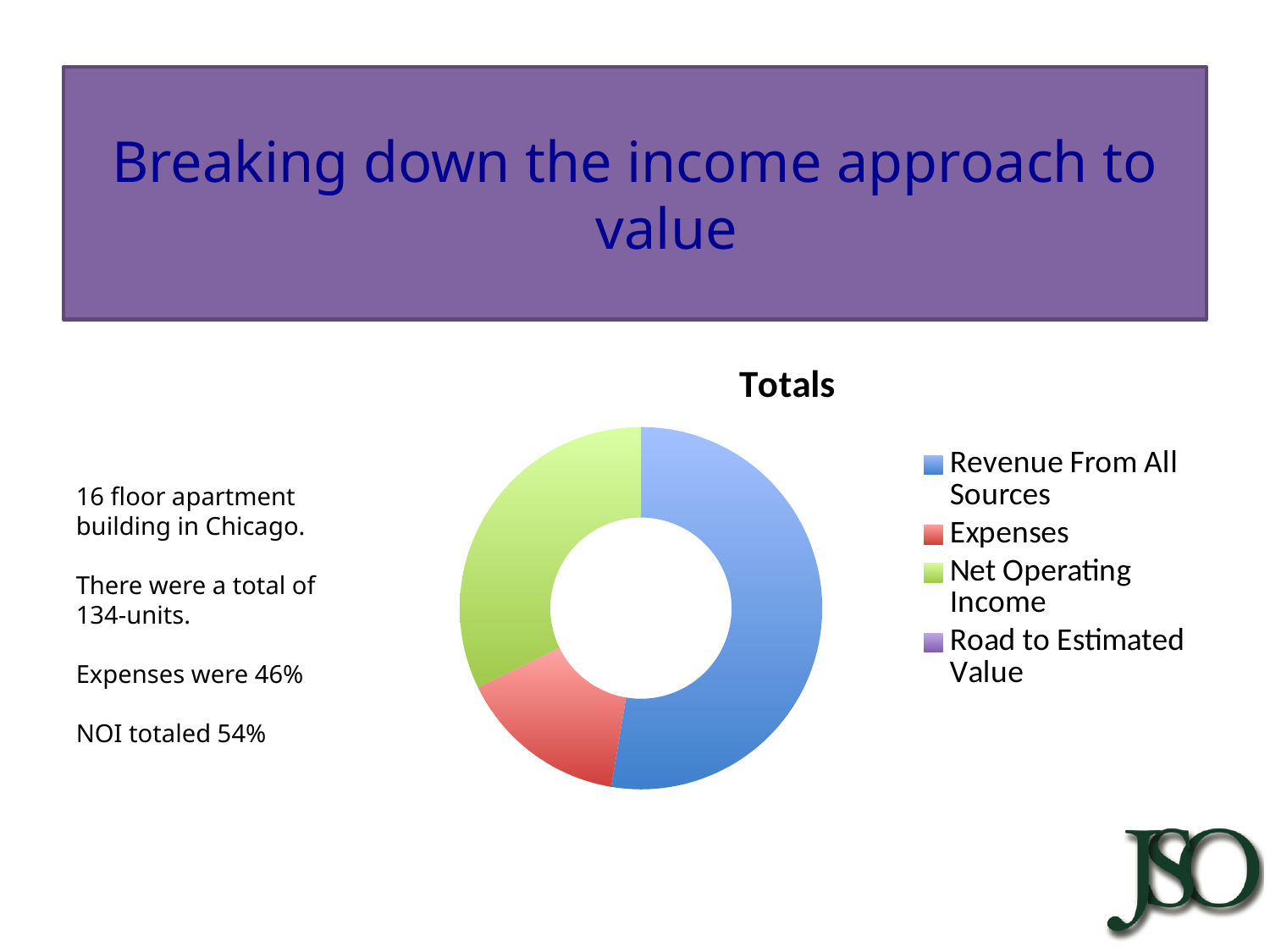
Which legend entry is shown in green? Net Operating Income What kind of chart is shown on the slide? Doughnut chart Which category takes up the largest portion of the doughnut chart? Revenue From All Sources Which is larger in the chart, Net Operating Income or Expenses? Net Operating Income How many entries does the chart's legend list? 4 What colour represents Expenses in the chart? Red Which visible slice of the doughnut chart is the smallest? Expenses Which is larger in the chart, Revenue From All Sources or Expenses? Revenue From All Sources What is the title of the chart? Totals